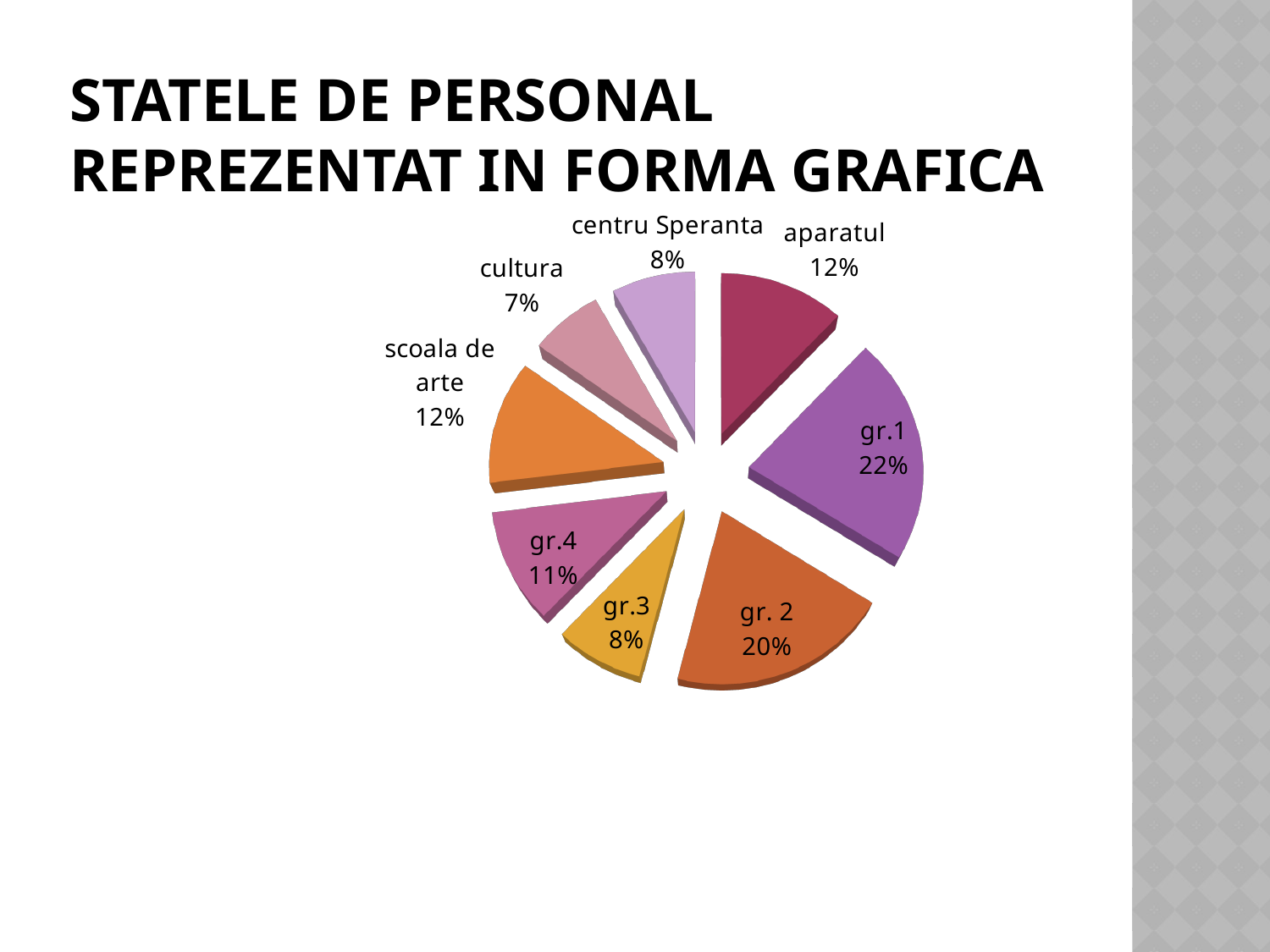
What is the difference in percentage points between gr.4 and gr.3? 3 How many slices does the pie chart have? 8 Which category has the largest slice of the pie? gr.1 What share of the pie does gr.1 have? 22% What percentage is shown for cultura? 7% What kind of chart is shown on the slide? pie chart What is the difference in percentage points between gr.1 and gr. 2? 2 Which category has the smallest slice of the pie? cultura What is the title of the slide containing the pie chart? STATELE DE PERSONAL REPREZENTAT IN FORMA GRAFICA What percentage is shown for centru Speranta? 8% Which is larger, the share for aparatul or the share for cultura? aparatul What percentage is shown for scoala de arte? 12%